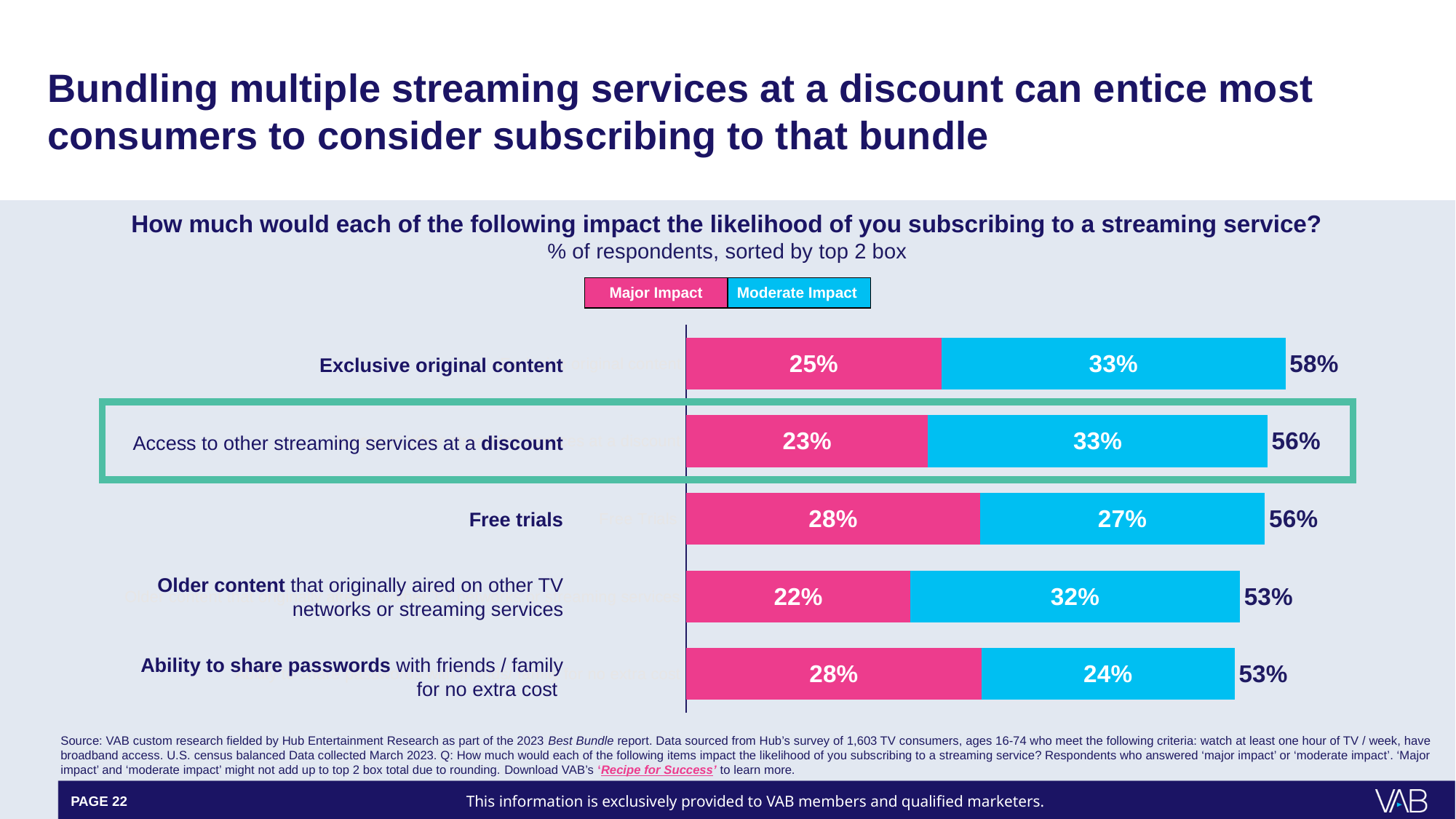
What is the top 2 box total shown for Ability to share passwords with friends / family for no extra cost? 53% What is the Moderate Impact value for Free trials? 27% How many categories are plotted in the chart? 5 Which category has the lowest Major Impact value? Older content that originally aired on other TV networks or streaming services Which is larger: the Major Impact value for Free trials or the Major Impact value for Exclusive original content? Free trials What is the Major Impact value for Access to other streaming services at a discount? 23% Which category has the highest top 2 box total? Exclusive original content How many series does the legend list? 2 What kind of chart is shown on the slide? Stacked bar chart What is the Major Impact value for Exclusive original content? 25% What is the top 2 box total shown for Exclusive original content? 58% What is the difference between the Moderate Impact values for Exclusive original content and Ability to share passwords with friends / family for no extra cost? 9%